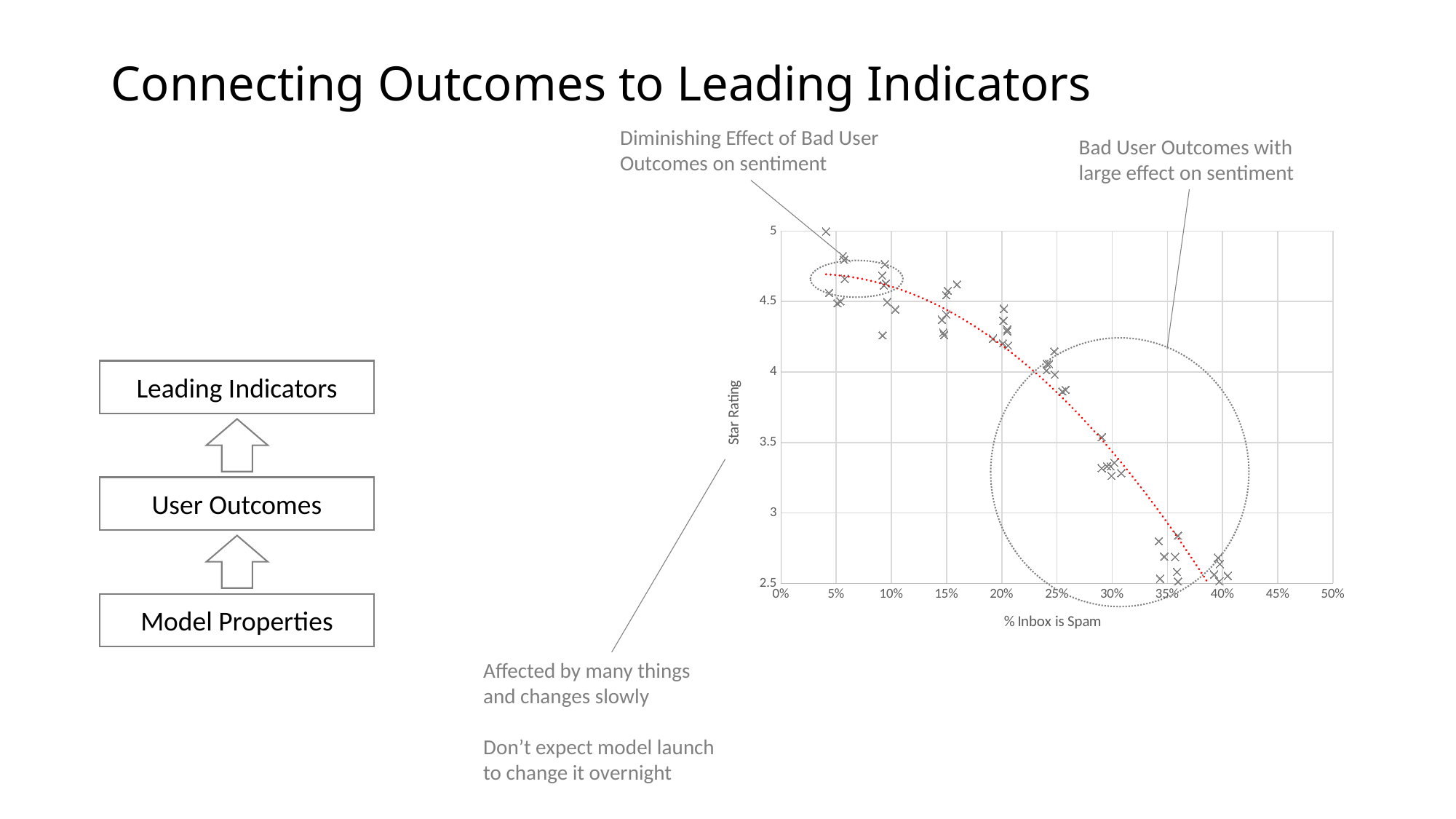
Are the star ratings for the points at around 30% inbox spam greater or less than 3? greater As % Inbox is Spam increases along the x axis, does Star Rating rise or fall? fall Are the star ratings for the points at around 25% inbox spam greater or less than 3.5? greater Is the highest star rating plotted on the chart greater or less than 4.5? greater Which group of points has higher star ratings: those near 10% inbox spam or those near 35% inbox spam? those near 10% inbox spam What is the label of the x axis of the chart? % Inbox is Spam What kind of chart is shown on the slide? scatter chart What is the label of the y axis of the chart? Star Rating